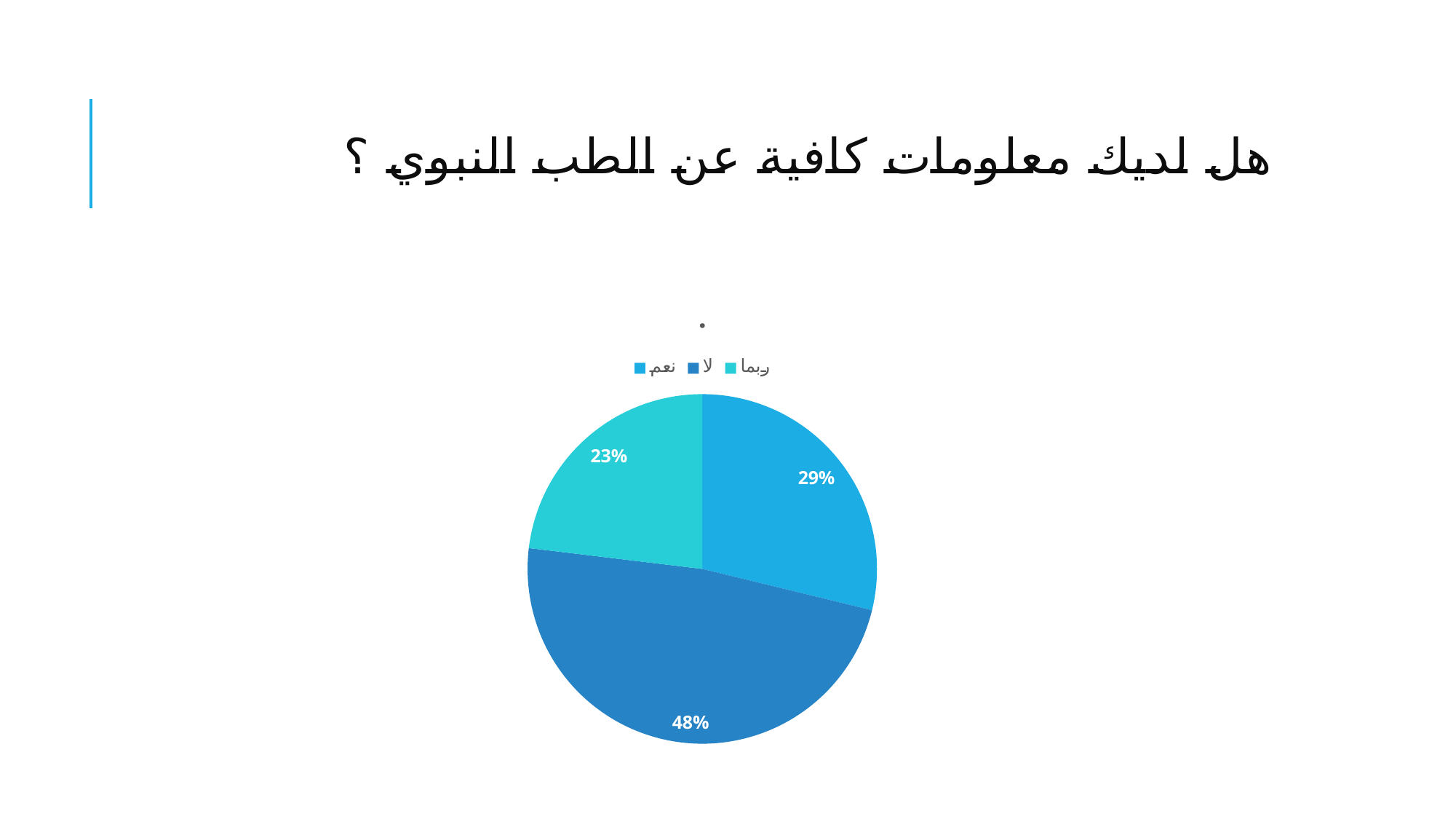
What is the difference in percentage points between the لا slice and the نعم slice? 19 What percentage of the pie is the slice for ربما? 23% Which slice is larger, نعم or ربما? نعم How many entries does the legend list? 3 What is the question written as the slide title above the chart? هل لديك معلومات كافية عن الطب النبوي ؟ What percentage of the pie is the slice for نعم? 29% Which category has the largest slice of the pie? لا Which category has the smallest slice of the pie? ربما How many slices does the pie chart have? 3 What kind of chart is shown on the slide? Pie chart What is the combined share of the نعم and ربما slices? 52% What percentage of the pie is the slice for لا? 48%